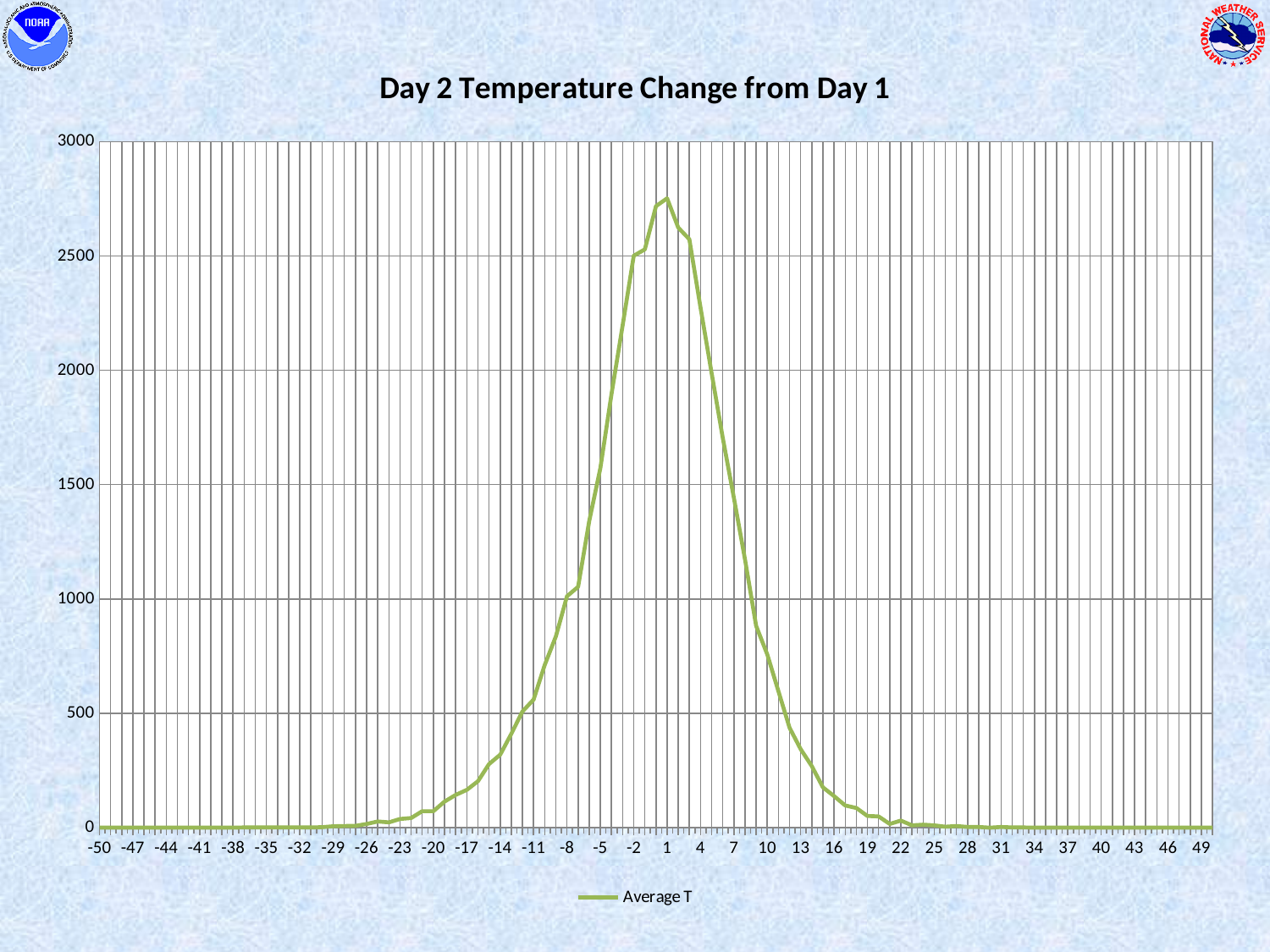
Is the value for Average T at 1 greater or less than 2500? greater What kind of chart is shown on the slide? line chart Which has the larger Average T value, -5 or 10? -5 Is the value for Average T at -2 greater or less than 2000? greater Does the Average T line rise or fall as the x axis goes from 1 to 49? fall At which x-axis value does the Average T line reach its peak? 1 Is the value for Average T at -50 greater or less than 500? less What is the title of the chart? Day 2 Temperature Change from Day 1 What is the name of the series shown in the legend? Average T How many series does the legend list? 1